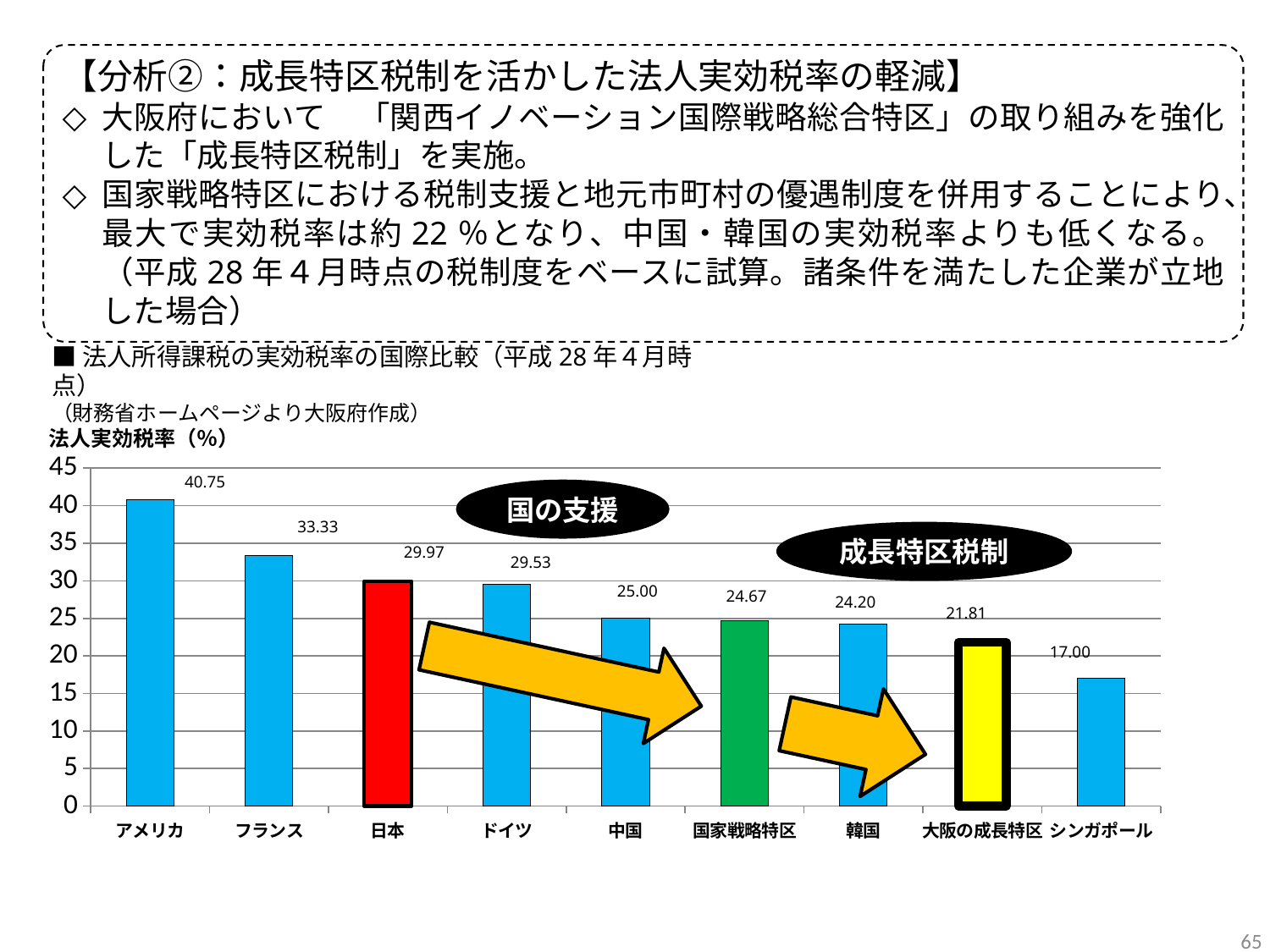
What is the value for 韓国? 24.20 What colour is the bar for 大阪の成長特区? Yellow What is the value for 大阪の成長特区? 21.81 Which is larger, the value for 中国 or the value for 大阪の成長特区? 中国 What is the value for アメリカ? 40.75 Which category has the highest value? アメリカ How many categories are shown on the x axis? 9 What is the difference between the values for 日本 and 大阪の成長特区? 8.16 What is the value for 国家戦略特区? 24.67 What kind of chart is shown on the slide? Bar chart Which category has the lowest value? シンガポール What is the difference between the values for アメリカ and フランス? 7.42